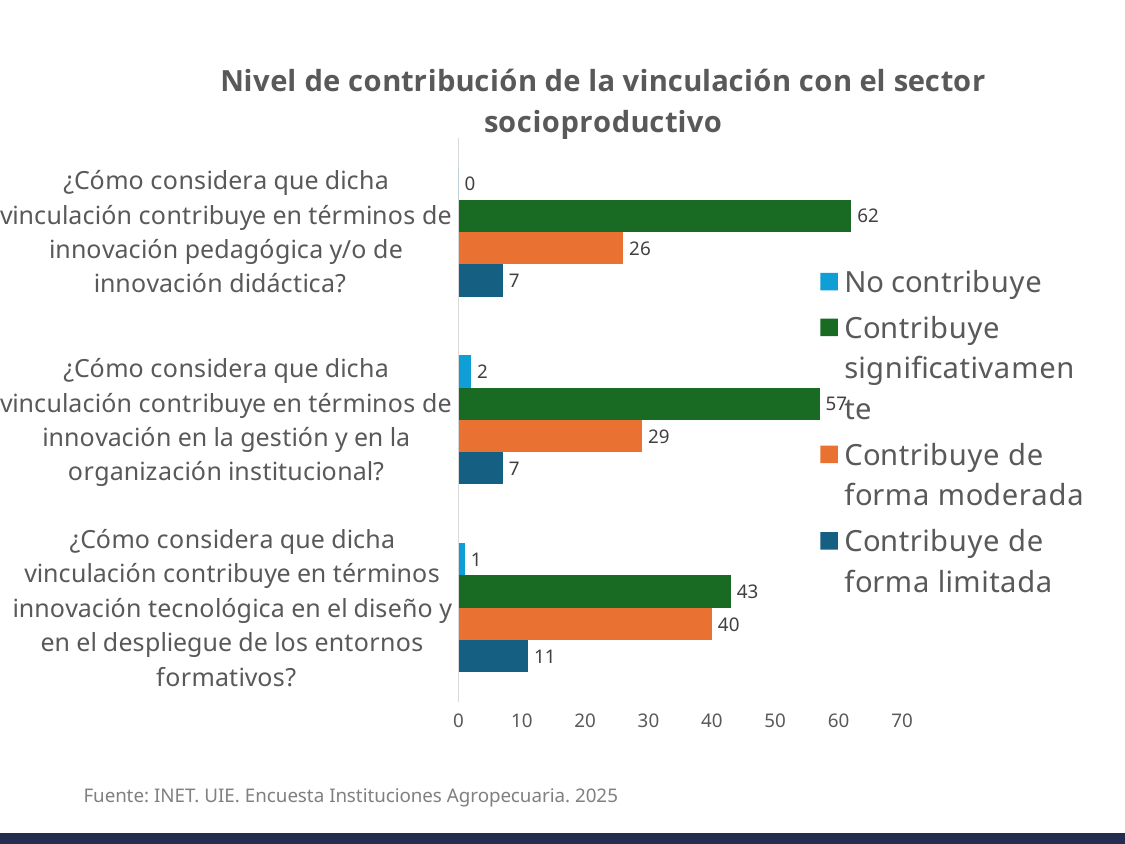
For the question about innovación en la gestión y en la organización institucional, which is larger: "Contribuye significativamente" or "Contribuye de forma moderada"? Contribuye significativamente How many questions (categories) are shown on the chart? 3 What is the value of "Contribuye significativamente" for the question about innovación pedagógica y/o de innovación didáctica? 62 What is the title of the chart? Nivel de contribución de la vinculación con el sector socioproductivo Is the value of "Contribuye significativamente" for the question about innovación en la gestión y en la organización institucional greater or less than 50? greater Which question has the highest value for "Contribuye significativamente"? ¿Cómo considera que dicha vinculación contribuye en términos de innovación pedagógica y/o de innovación didáctica? What is the difference between "Contribuye significativamente" and "Contribuye de forma moderada" for the question about innovación tecnológica? 3 What is the value of "No contribuye" for the question about innovación en la gestión y en la organización institucional? 2 What kind of chart is shown on the slide? Bar chart Which question has the lowest value for "Contribuye de forma moderada"? ¿Cómo considera que dicha vinculación contribuye en términos de innovación pedagógica y/o de innovación didáctica? What is the value of "Contribuye de forma moderada" for the question about innovación tecnológica en el diseño y en el despliegue de los entornos formativos? 40 How many series does the legend list? 4